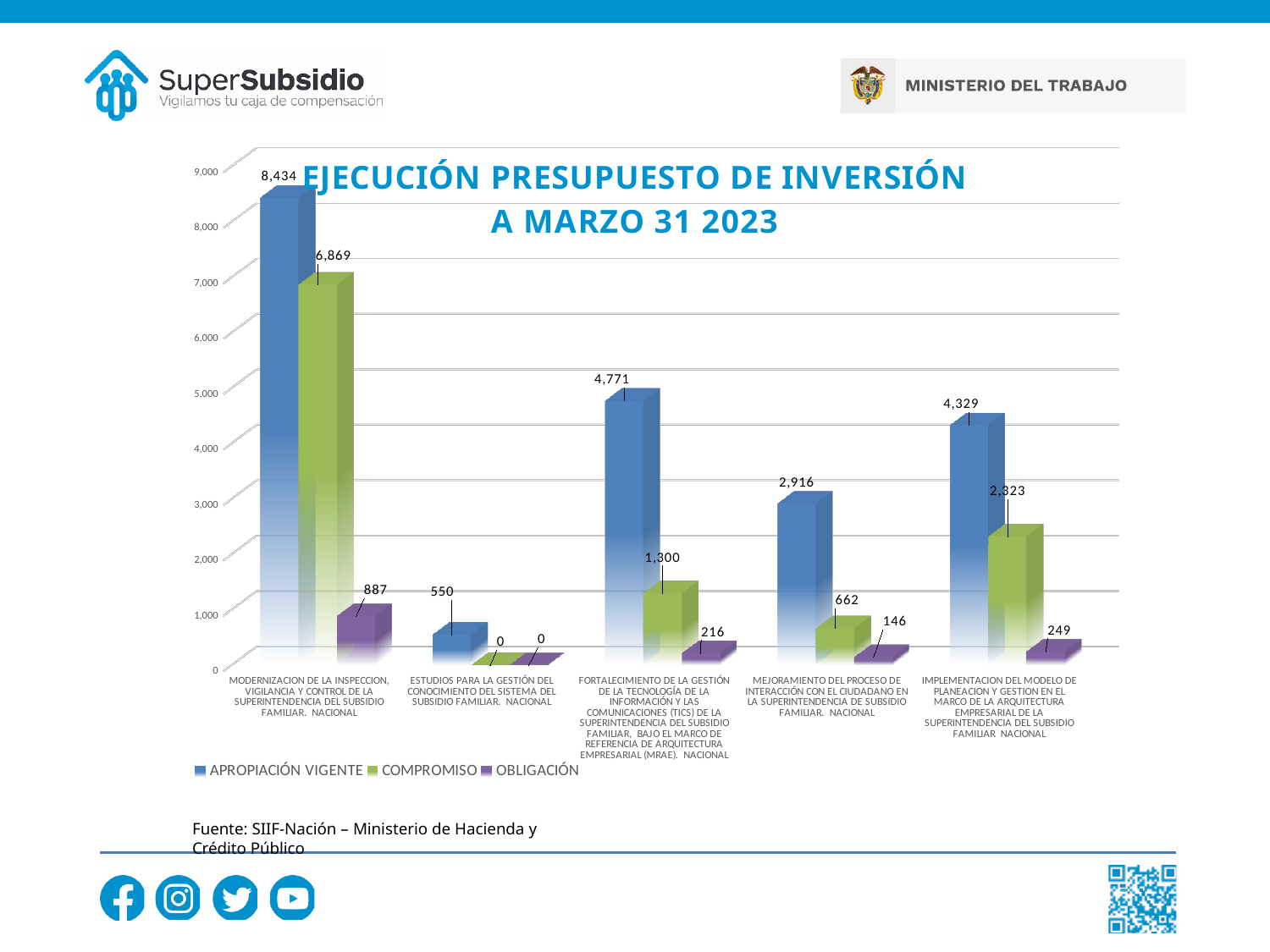
Which category has the highest APROPIACIÓN VIGENTE value? MODERNIZACION DE LA INSPECCION, VIGILANCIA Y CONTROL DE LA SUPERINTENDENCIA DEL SUBSIDIO FAMILIAR. NACIONAL What is the COMPROMISO value for FORTALECIMIENTO DE LA GESTIÓN DE LA TECNOLOGÍA DE LA INFORMACIÓN Y LAS COMUNICACIONES (TICS)? 1,300 What kind of chart is shown on the slide? Bar chart What is the OBLIGACIÓN value for IMPLEMENTACION DEL MODELO DE PLANEACION Y GESTION EN EL MARCO DE LA ARQUITECTURA EMPRESARIAL? 249 What is the title of the chart? EJECUCIÓN PRESUPUESTO DE INVERSIÓN A MARZO 31 2023 Is the APROPIACIÓN VIGENTE value for FORTALECIMIENTO DE LA GESTIÓN DE LA TECNOLOGÍA DE LA INFORMACIÓN greater or less than 4,000? greater Which category has the lowest APROPIACIÓN VIGENTE value? ESTUDIOS PARA LA GESTIÓN DEL CONOCIMIENTO DEL SISTEMA DEL SUBSIDIO FAMILIAR. NACIONAL Which is larger: the COMPROMISO value for IMPLEMENTACION DEL MODELO DE PLANEACION Y GESTION or the COMPROMISO value for FORTALECIMIENTO DE LA GESTIÓN DE LA TECNOLOGÍA DE LA INFORMACIÓN? IMPLEMENTACION DEL MODELO DE PLANEACION Y GESTION How many categories are shown on the x axis of the chart? 5 How many series does the legend list? 3 What is the difference between the APROPIACIÓN VIGENTE and COMPROMISO values for MEJORAMIENTO DEL PROCESO DE INTERACCIÓN CON EL CIUDADANO? 2,254 What is the APROPIACIÓN VIGENTE value for MODERNIZACION DE LA INSPECCION, VIGILANCIA Y CONTROL DE LA SUPERINTENDENCIA DEL SUBSIDIO FAMILIAR. NACIONAL? 8,434